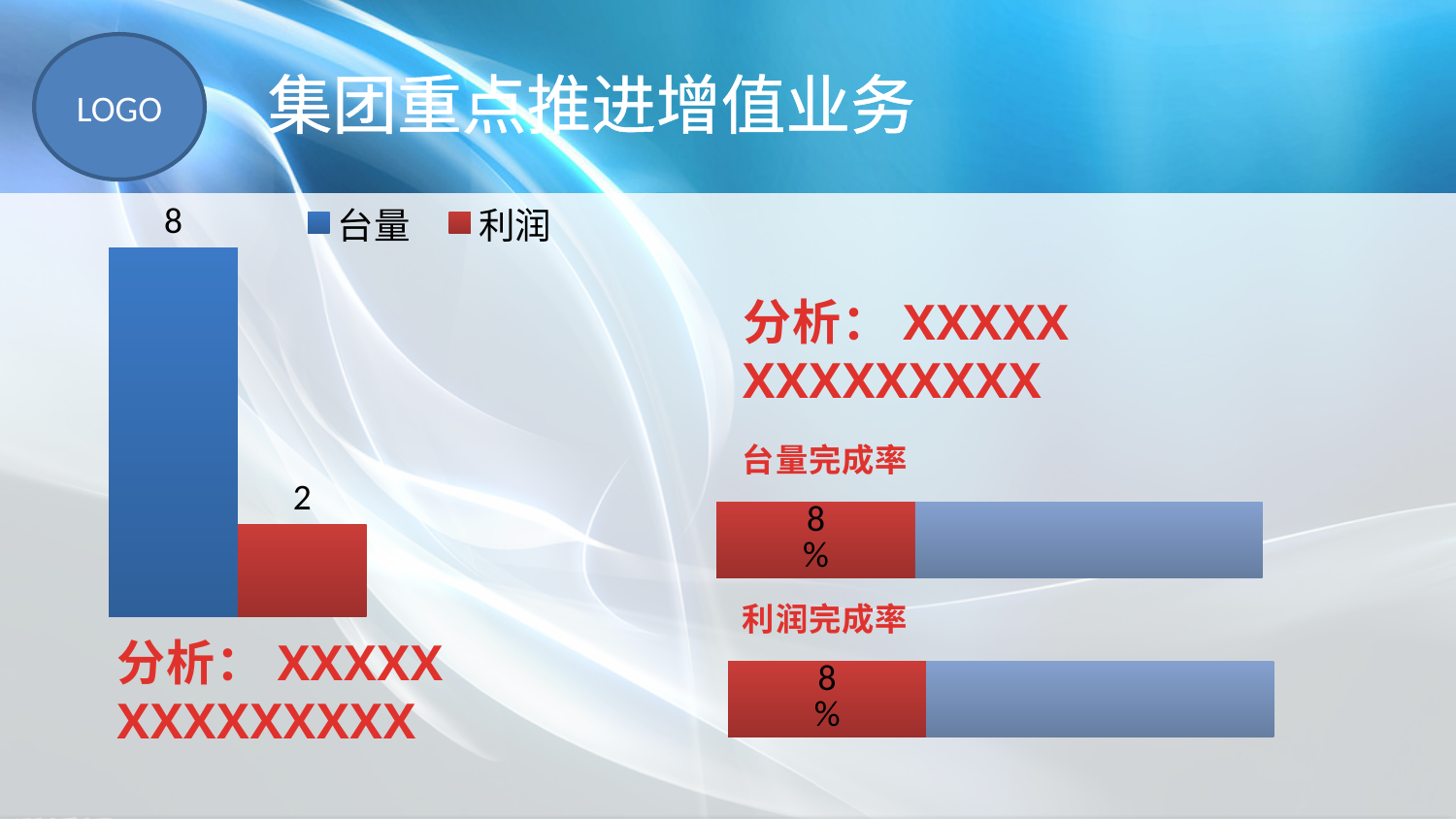
In the bar chart on the left, which series has the highest value? 台量 In the bar chart on the left, which is larger, 台量 or 利润? 台量 In the bar chart on the left, which series has the lowest value? 利润 In the bar chart on the left, what colour represents 利润 in the legend? red In the bar chart on the left, what colour represents 台量 in the legend? blue How many bars are plotted in the bar chart on the left? 2 In the bar chart on the left, what is the difference between the 台量 value and the 利润 value? 6 In the progress bar labeled 台量完成率 on the right, what percentage is shown? 8% In the bar chart on the left, what is the value for 台量? 8 In the bar chart on the left, what is the value for 利润? 2 How many series does the legend of the bar chart on the left list? 2 What kind of chart is shown on the left of the slide? bar chart